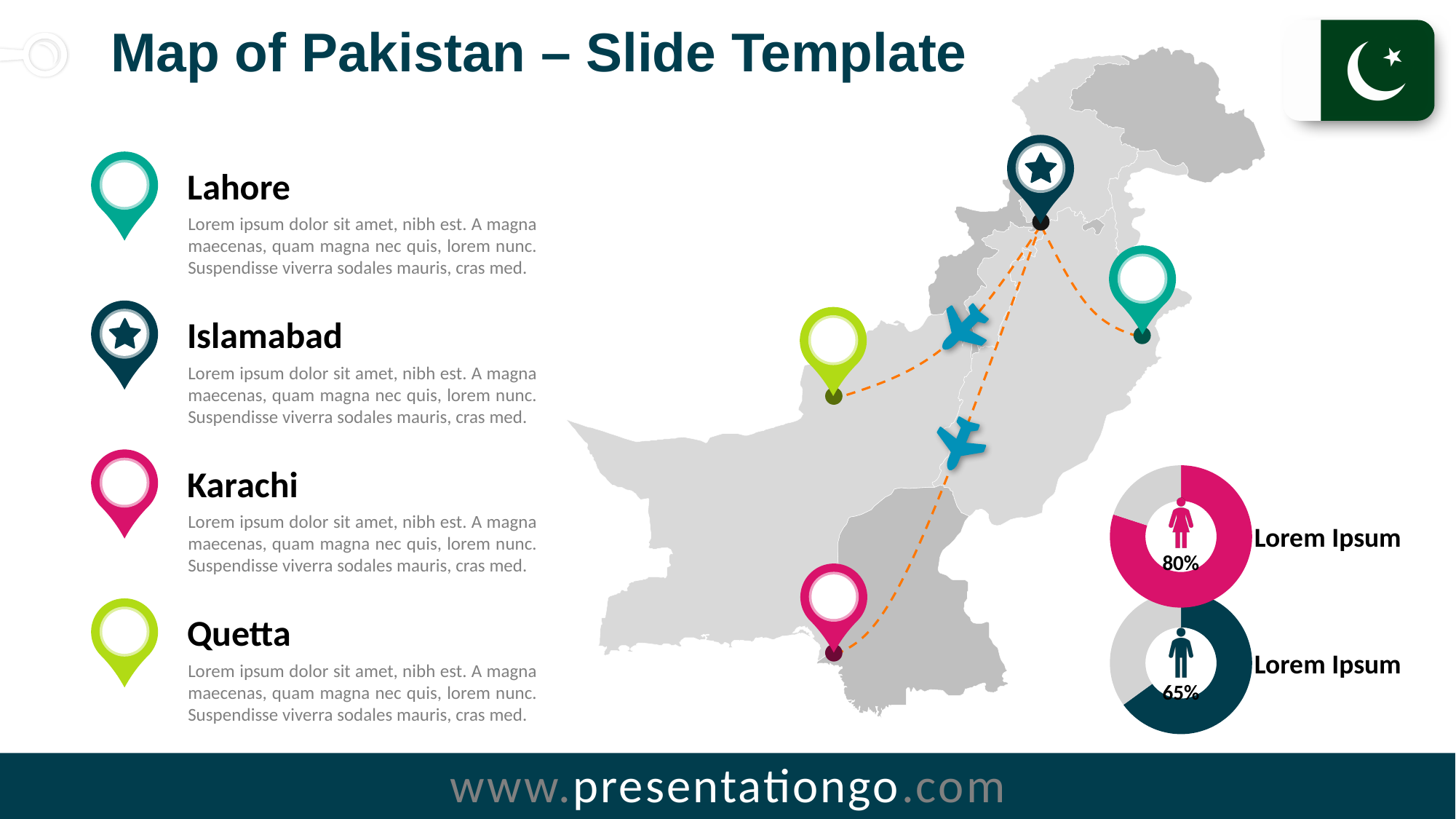
Which donut chart shows the larger percentage, the one with the female icon or the one with the male icon? The one with the female icon How many donut charts are on the slide? 2 Is the value in the lower donut chart with the male icon greater or less than 50%? greater What colour is the filled portion of the upper donut chart showing 80%? Pink What is the difference in percentage points between the upper donut chart (80%) and the lower donut chart (65%)? 15 percentage points Which donut chart shows the smaller percentage? The lower one with the male icon (65%) What label appears next to each donut chart? Lorem Ipsum What percentage is shown in the lower donut chart with the male icon? 65% What kind of charts are shown at the bottom right of the slide? Donut charts What percentage is shown in the upper donut chart with the female icon? 80%